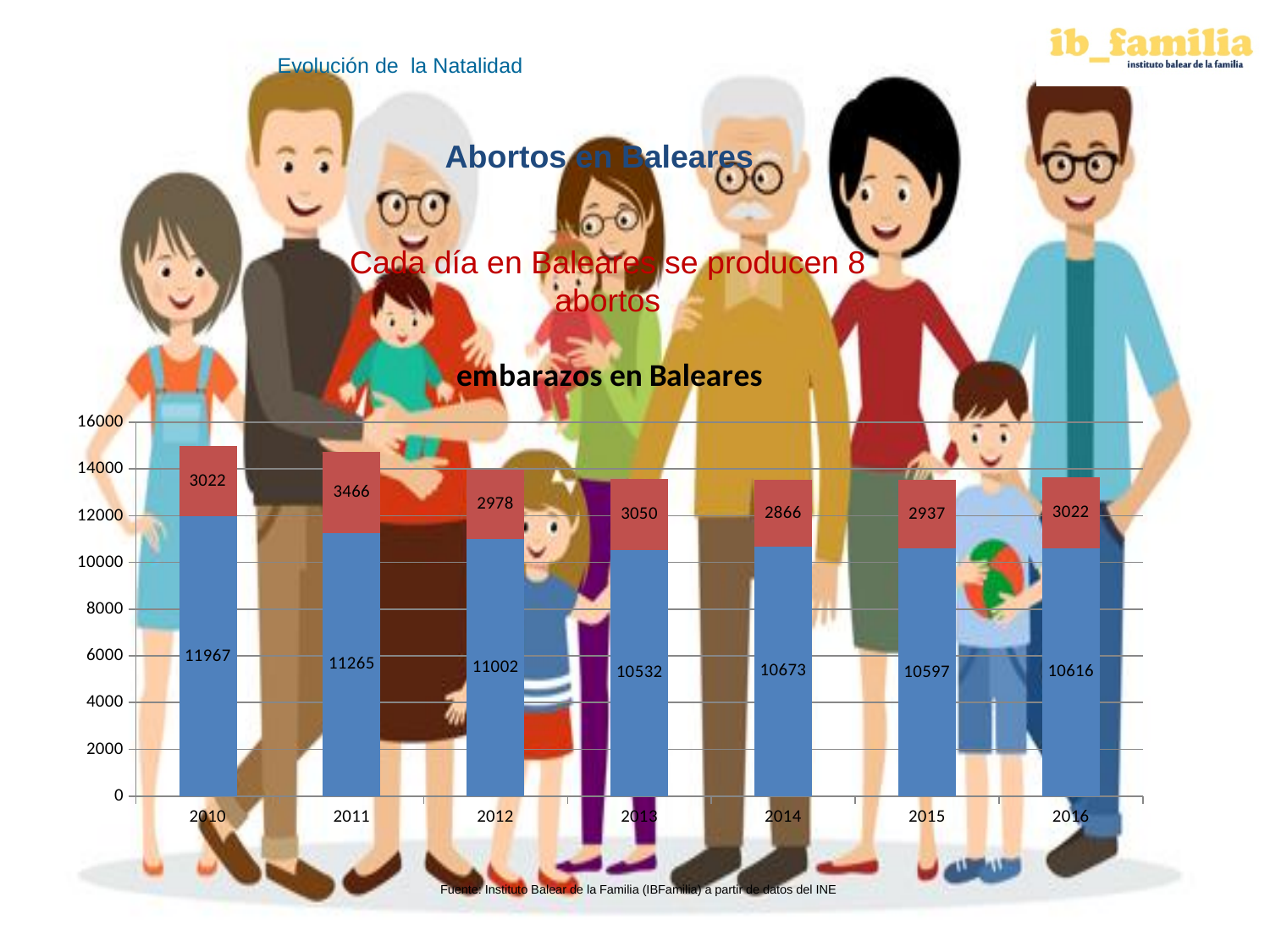
What is the value of the blue (bottom) segment for 2016? 10616 What is the title of the chart? embarazos en Baleares What is the value of the blue (bottom) segment for 2010? 11967 What kind of chart is shown on the slide? bar chart In which year is the blue (bottom) segment the lowest? 2013 What is the value of the red (top) segment for 2011? 3466 How many years are shown on the x axis of the chart? 7 In which year is the red (top) segment the highest? 2011 What is the total of the stacked bar for 2010? 14989 What is the difference between the blue segment values for 2010 and 2011? 702 Does the blue (bottom) segment rise or fall from 2010 to 2013? fall Which is larger, the red segment for 2014 or the red segment for 2015? 2015